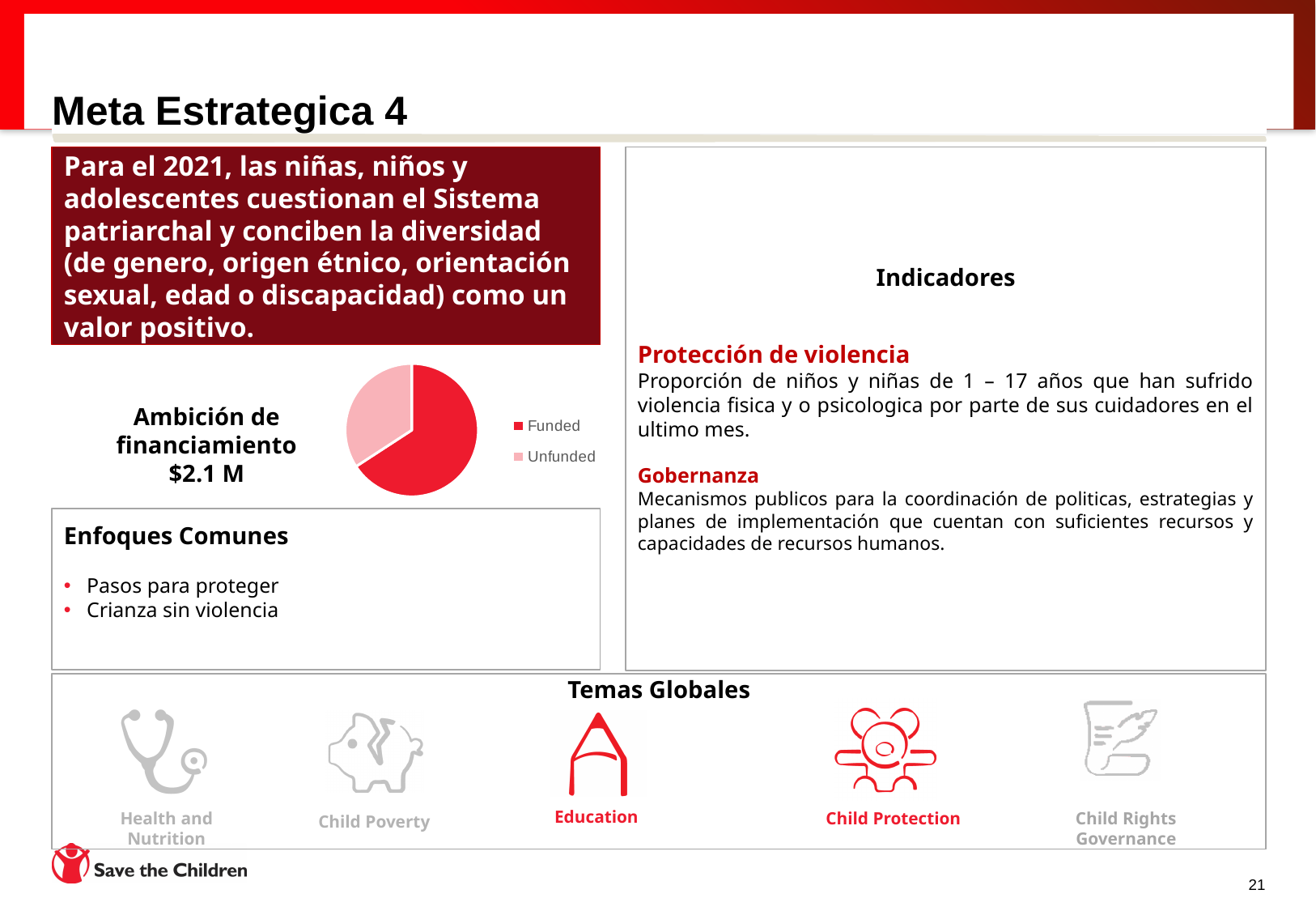
Which slice of the pie chart is the largest? Funded What are the two legend entries of the pie chart? Funded, Unfunded Which colour represents the Unfunded slice in the pie chart? light pink How many slices does the pie chart have? 2 What kind of chart is shown next to "Ambición de financiamiento"? pie chart How many entries does the pie chart's legend list? 2 In the pie chart, which is larger: Funded or Unfunded? Funded Which slice of the pie chart is the smallest? Unfunded